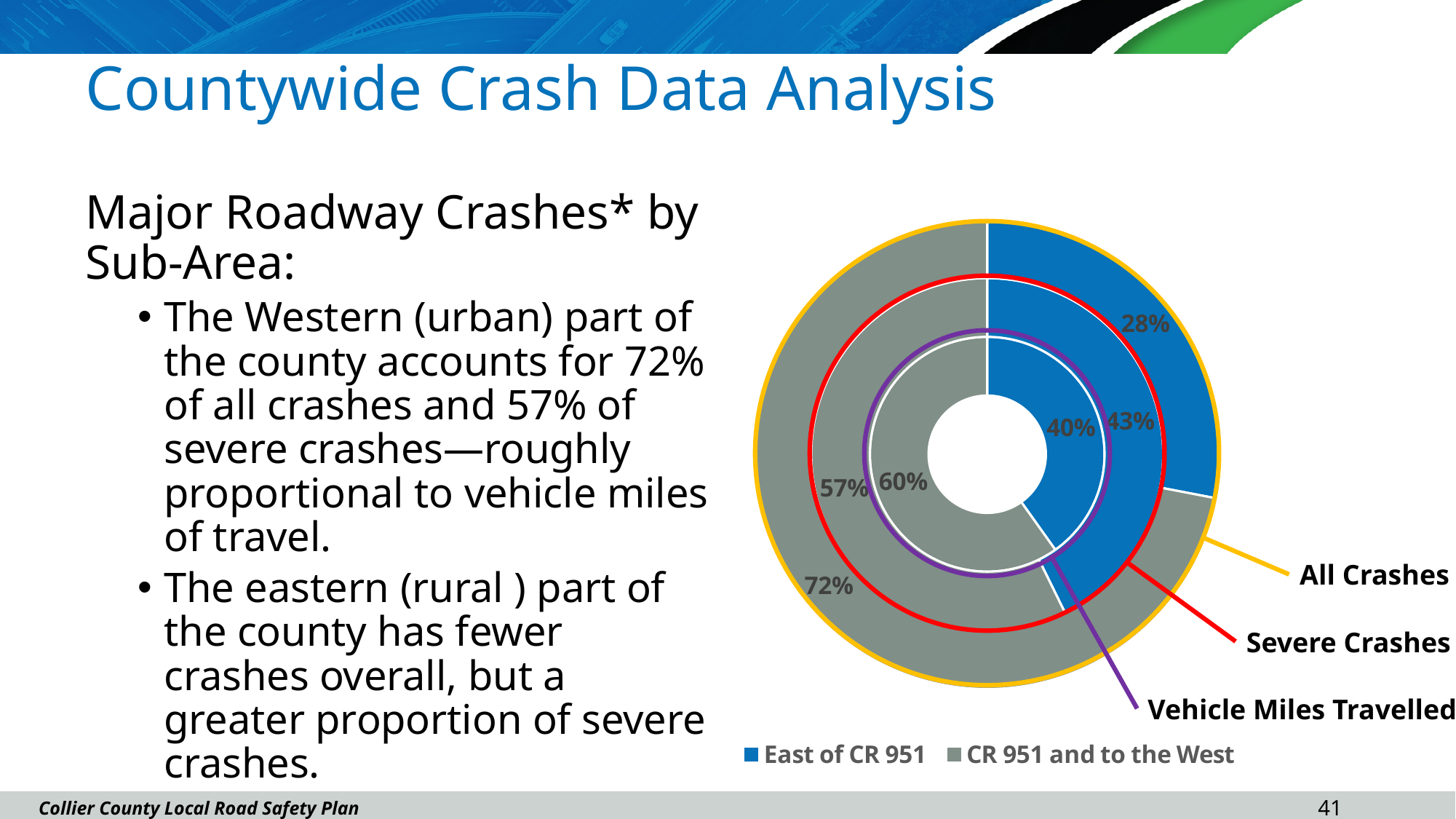
In the All Crashes ring, what share of crashes is attributed to East of CR 951? 28% In the Severe Crashes ring, what share is attributed to CR 951 and to the West? 57% What is the difference between the West share of All Crashes and the West share of Severe Crashes? 15% Which ring shows the larger share for East of CR 951: All Crashes or Severe Crashes? Severe Crashes How many series does the legend list? 2 In the Vehicle Miles Travelled ring, what share is attributed to CR 951 and to the West? 60% In the All Crashes ring, what share of crashes is attributed to CR 951 and to the West? 72% What kind of chart is shown on the slide? Doughnut chart In the Vehicle Miles Travelled ring, what share is attributed to East of CR 951? 40% Which colour represents East of CR 951 in the chart? Blue In the Severe Crashes ring, what share is attributed to East of CR 951? 43% How many rings (measures) does the doughnut chart contain? 3